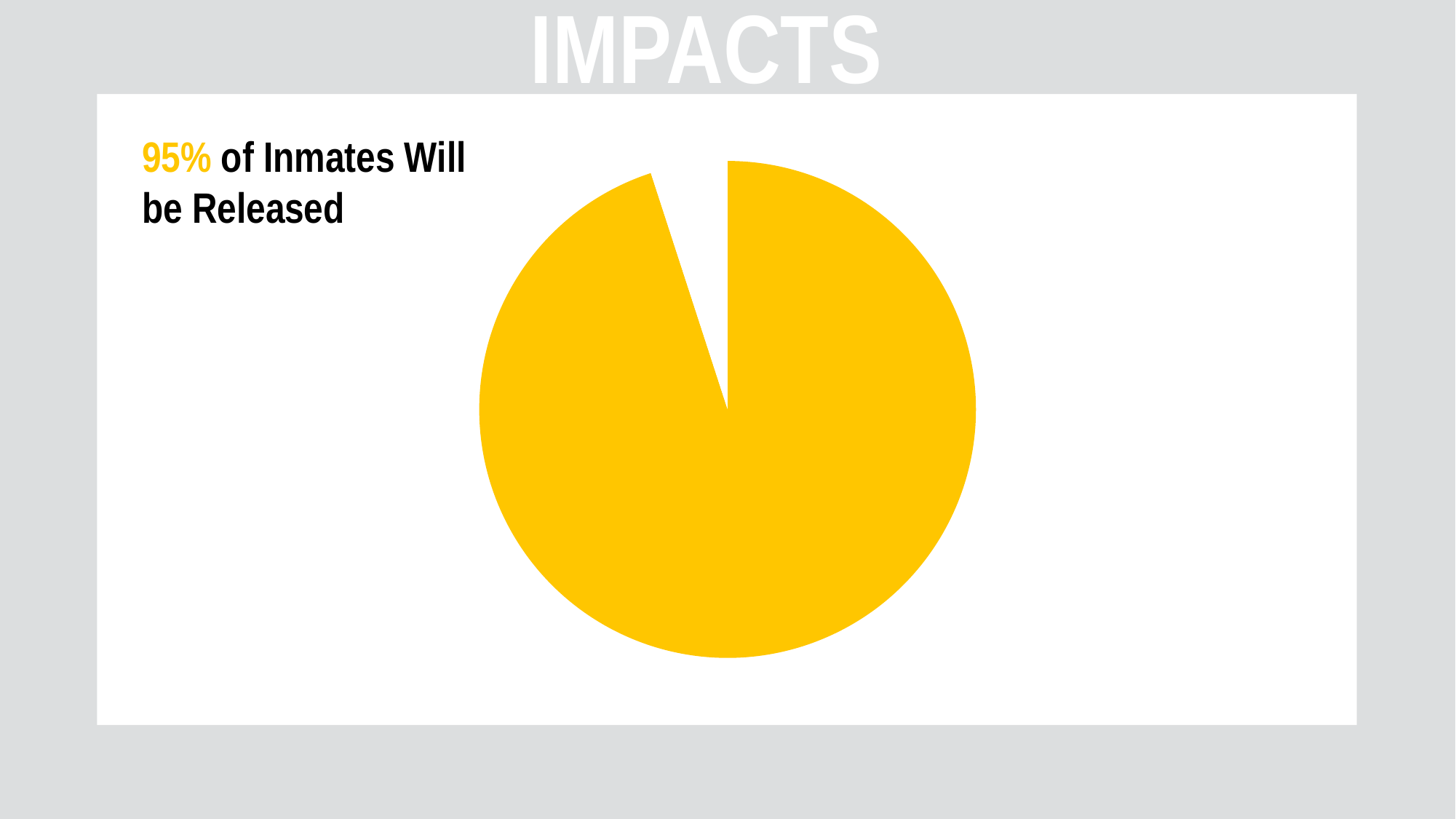
What colour is the large slice of the pie chart? yellow Which slice of the pie is larger, the yellow slice or the white slice? yellow slice What share of the pie does the yellow slice represent? 95% What kind of chart is shown on the slide? pie chart Which slice of the pie is the smallest? the white slice According to the slide, what percentage of inmates will be released? 95% What is the title at the top of the slide? IMPACTS How many slices does the pie chart have? 2